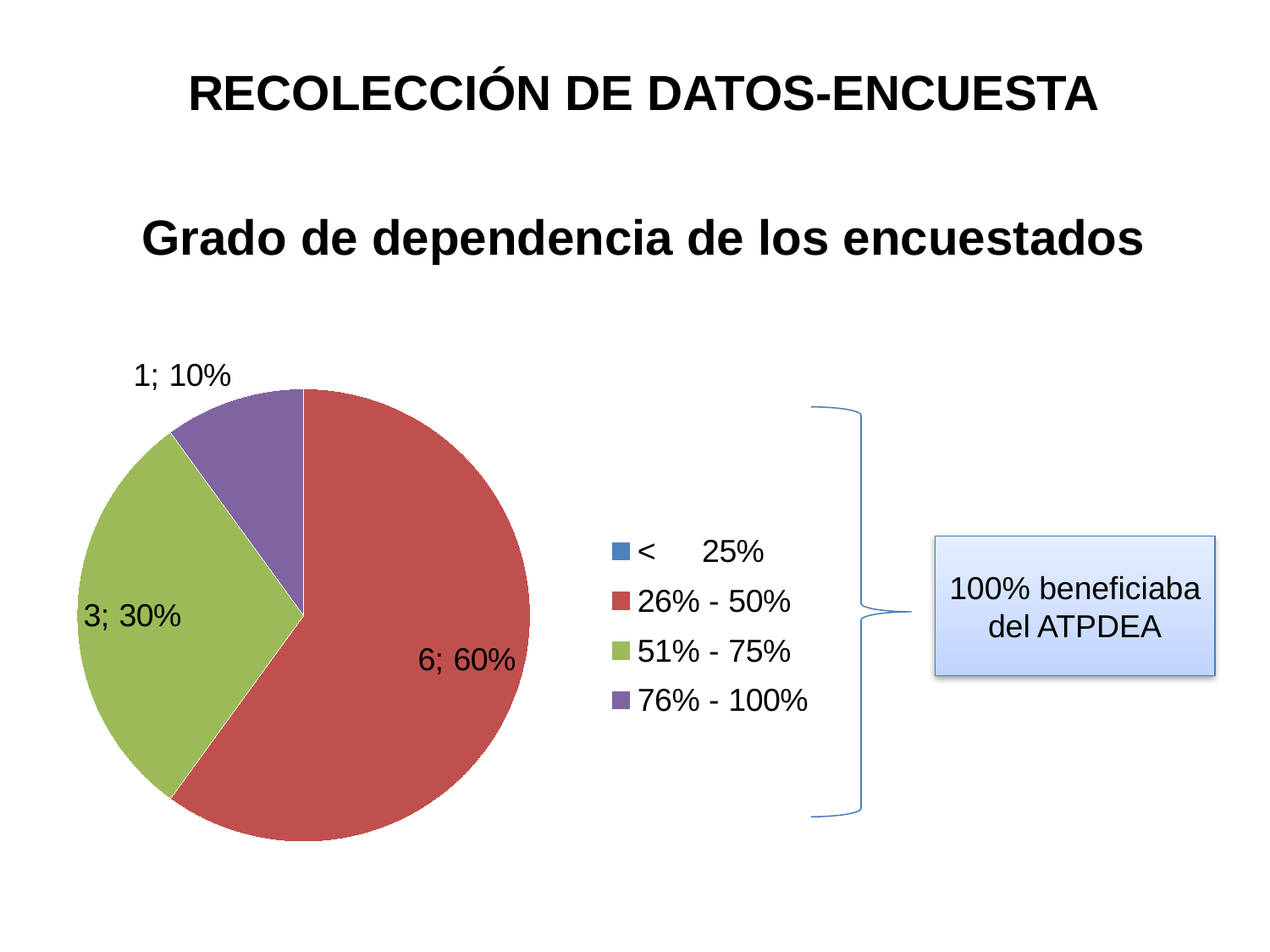
Which of the visible slices is the smallest? 76% - 100% What share of the pie does the 51% - 75% category represent? 30% What kind of chart is shown on the slide? pie chart Which category has the largest slice of the pie? 26% - 50% What share of the pie does the 76% - 100% category represent? 10% How many respondents fall in the 26% - 50% category? 6 What is the difference in respondent count between the 26% - 50% and 51% - 75% categories? 3 How many entries does the legend list? 4 What is the chart's title? Grado de dependencia de los encuestados What share of the pie does the 26% - 50% category represent? 60% How many respondents fall in the 51% - 75% category? 3 How many respondents fall in the 76% - 100% category? 1